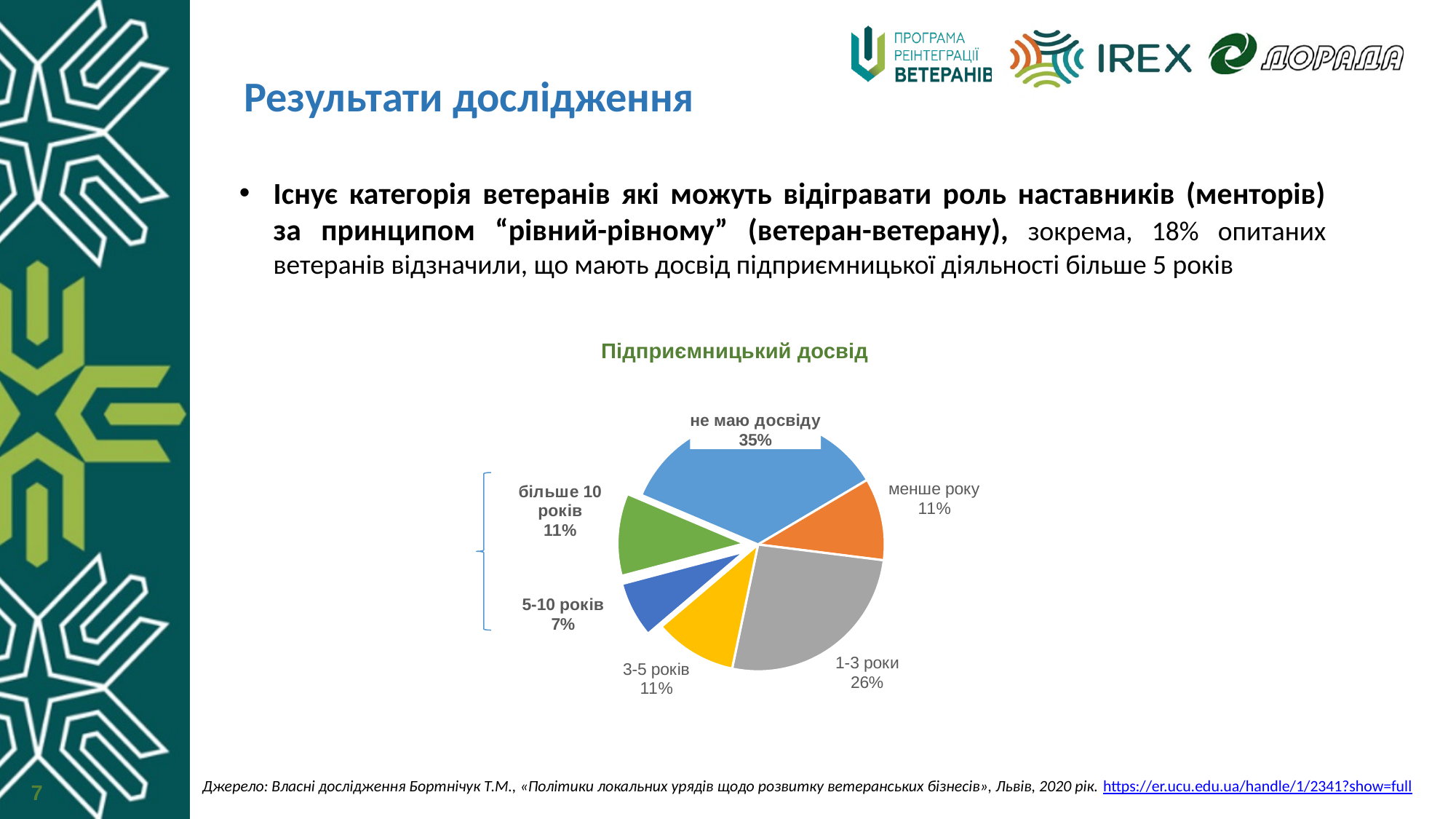
What is the combined share of '5-10 років' and 'більше 10 років' in the pie chart? 18% By how many percentage points does 'не маю досвіду' exceed '1-3 роки' in the pie chart? 9 percentage points What percentage is shown for '5-10 років' in the pie chart? 7% Which category has the smallest slice in the pie chart? 5-10 років What share of the pie chart 'Підприємницький досвід' is labelled 'не маю досвіду'? 35% What percentage is shown for 'більше 10 років' in the pie chart? 11% How many categories does the pie chart show? 6 What is the title of the chart on the slide? Підприємницький досвід Which slice is larger in the pie chart: '1-3 роки' or 'менше року'? 1-3 роки Which category has the largest slice in the pie chart? не маю досвіду What percentage is shown for '1-3 роки' in the pie chart? 26% What kind of chart is shown on the slide? Pie chart